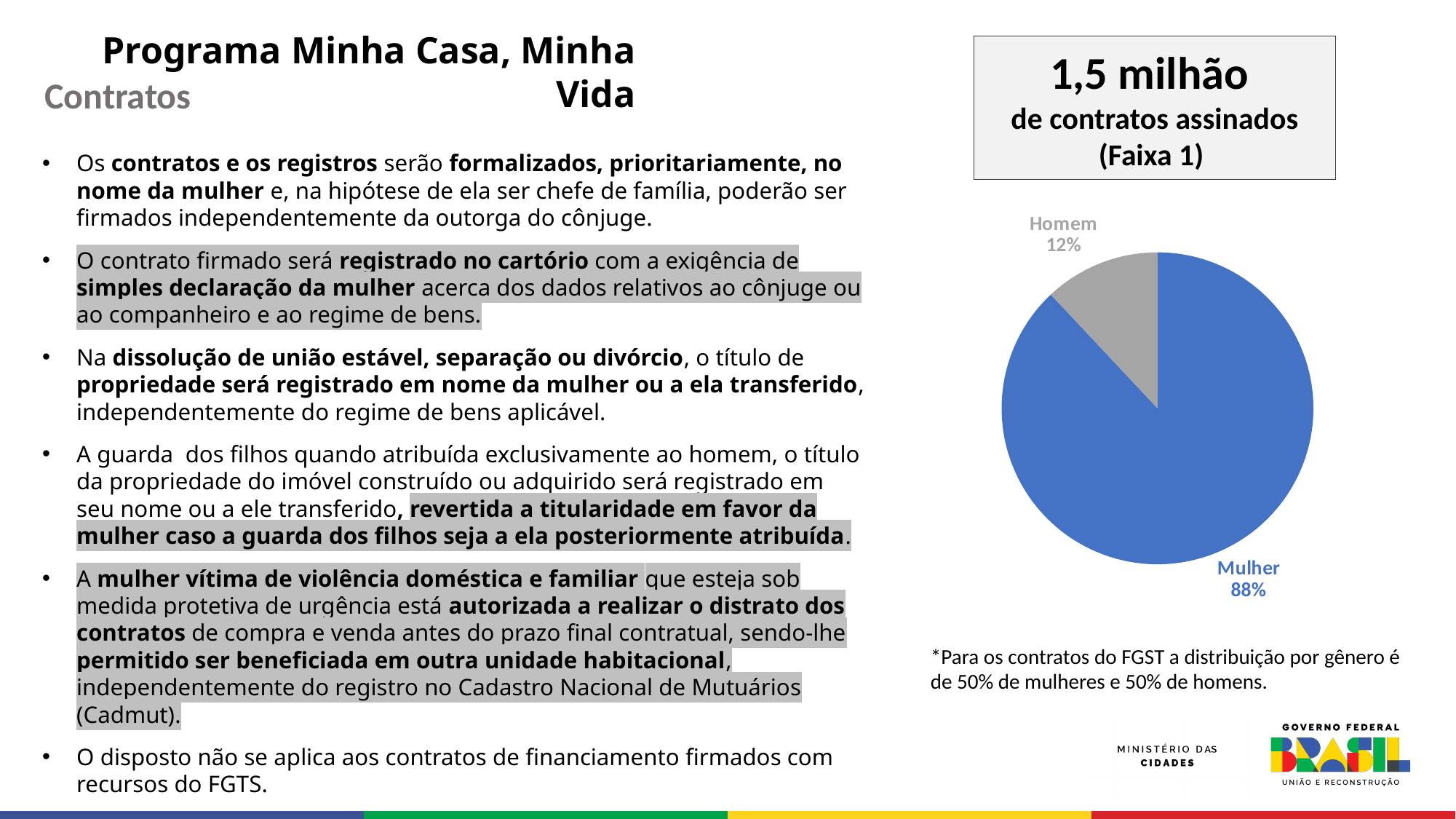
Which category has the largest slice in the pie chart? Mulher What share of the pie chart is labelled Homem? 12% How many slices does the pie chart have? 2 Which slice is larger, Mulher or Homem? Mulher Is the share for Mulher greater or less than 50%? greater Which category has the smallest slice in the pie chart? Homem Is the share for Homem greater or less than 50%? less What colour is the Mulher slice of the pie chart? Blue What kind of chart is shown on the slide? Pie chart What share of the pie chart is labelled Mulher? 88% What colour is the Homem slice of the pie chart? Grey What is the difference in percentage points between the Mulher and Homem slices? 76